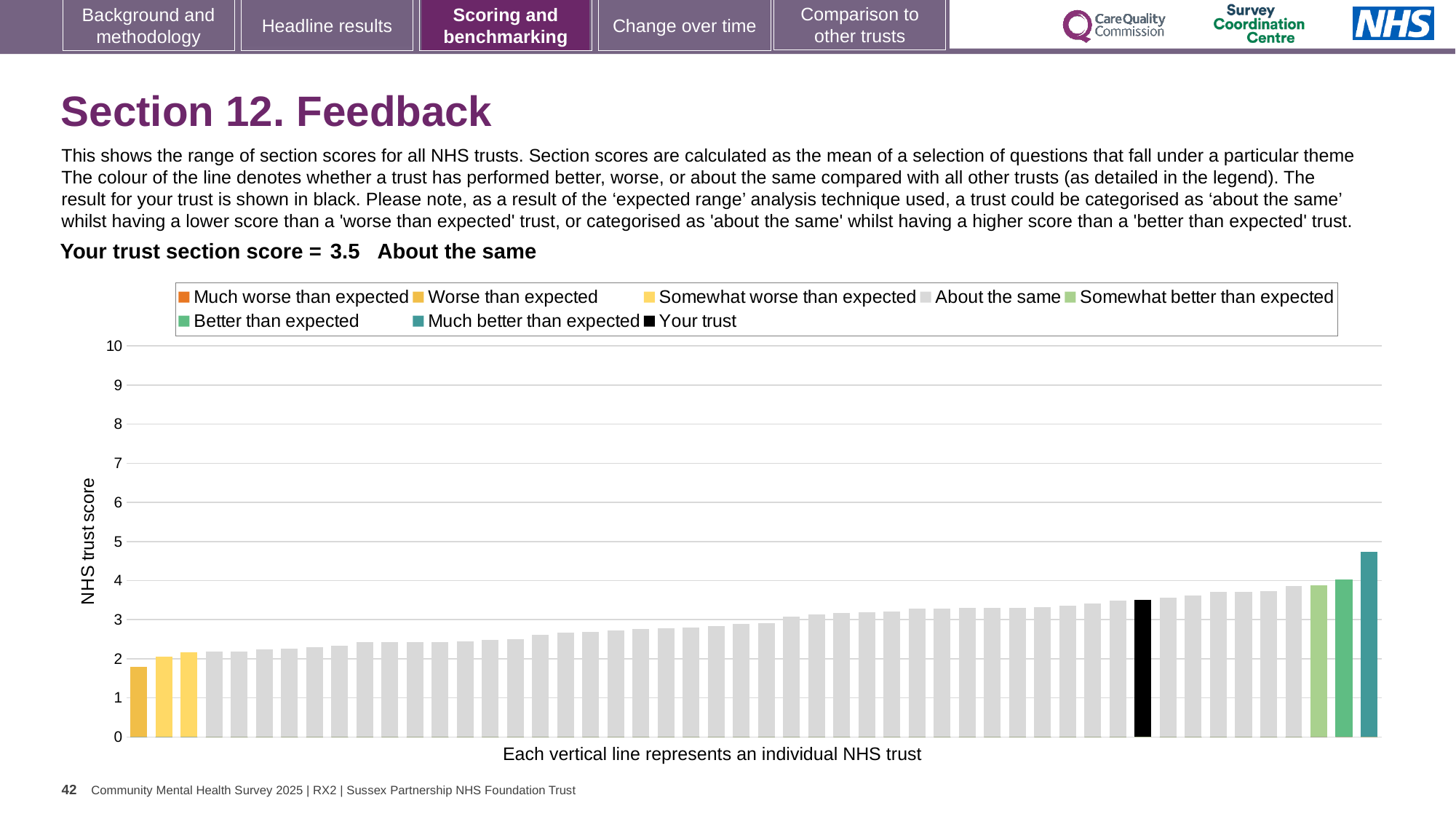
What kind of chart is shown on the slide? bar chart Is the value of the tallest bar greater or less than 4? greater Is the value for your trust (the black bar) greater or less than 3? greater Is the value of the shortest bar greater or less than 2? less How many entries does the chart legend list? 8 What is the title of the y axis? NHS trust score What colour is the bar representing your trust? black Which legend category does the tallest bar belong to? Much better than expected Do the bar values rise or fall from left to right along the x axis? rise What is the section score for your trust? 3.5